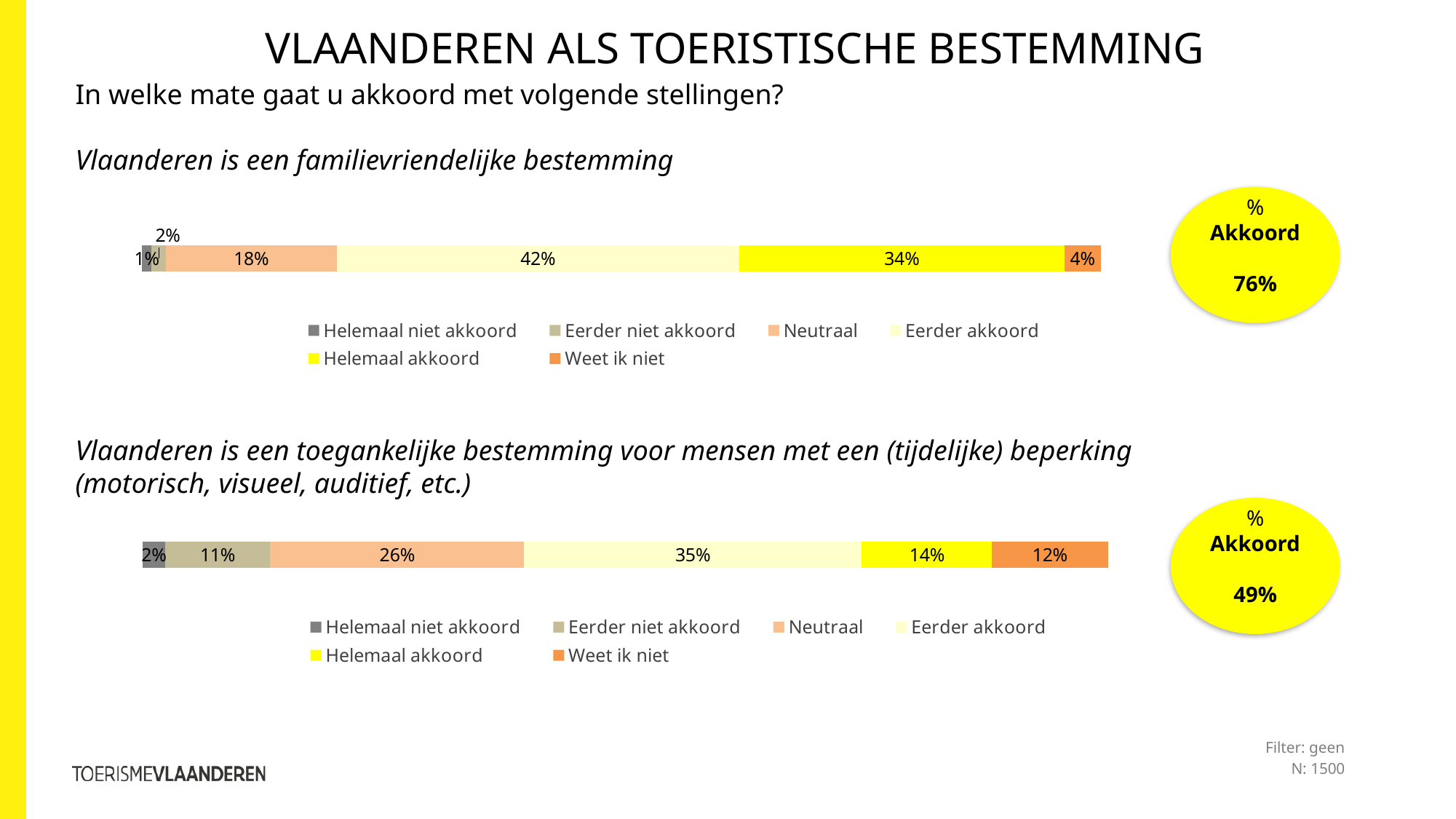
In the chart for 'Vlaanderen is een familievriendelijke bestemming', which response category has the smallest share? Helemaal niet akkoord In the chart for 'Vlaanderen is een familievriendelijke bestemming', what percentage is shown for 'Weet ik niet'? 4% In the chart for 'Vlaanderen is een toegankelijke bestemming voor mensen met een (tijdelijke) beperking', what percentage is shown for 'Neutraal'? 26% What kind of chart is used for 'Vlaanderen is een toegankelijke bestemming voor mensen met een (tijdelijke) beperking'? Stacked bar chart In the chart for 'Vlaanderen is een toegankelijke bestemming voor mensen met een (tijdelijke) beperking', what is the difference between 'Eerder akkoord' and 'Helemaal akkoord'? 21% What '% Akkoord' value is shown next to the chart for 'Vlaanderen is een toegankelijke bestemming voor mensen met een (tijdelijke) beperking'? 49% In the chart for 'Vlaanderen is een toegankelijke bestemming voor mensen met een (tijdelijke) beperking', what percentage is shown for 'Weet ik niet'? 12% In the chart for 'Vlaanderen is een familievriendelijke bestemming', what percentage is shown for 'Eerder akkoord'? 42% How many series does the legend list for the chart 'Vlaanderen is een familievriendelijke bestemming'? 6 In the chart for 'Vlaanderen is een toegankelijke bestemming voor mensen met een (tijdelijke) beperking', which response category has the largest share? Eerder akkoord In the chart for 'Vlaanderen is een familievriendelijke bestemming', what percentage is shown for 'Helemaal akkoord'? 34% In the chart for 'Vlaanderen is een familievriendelijke bestemming', which is larger: 'Neutraal' or 'Helemaal akkoord'? Helemaal akkoord